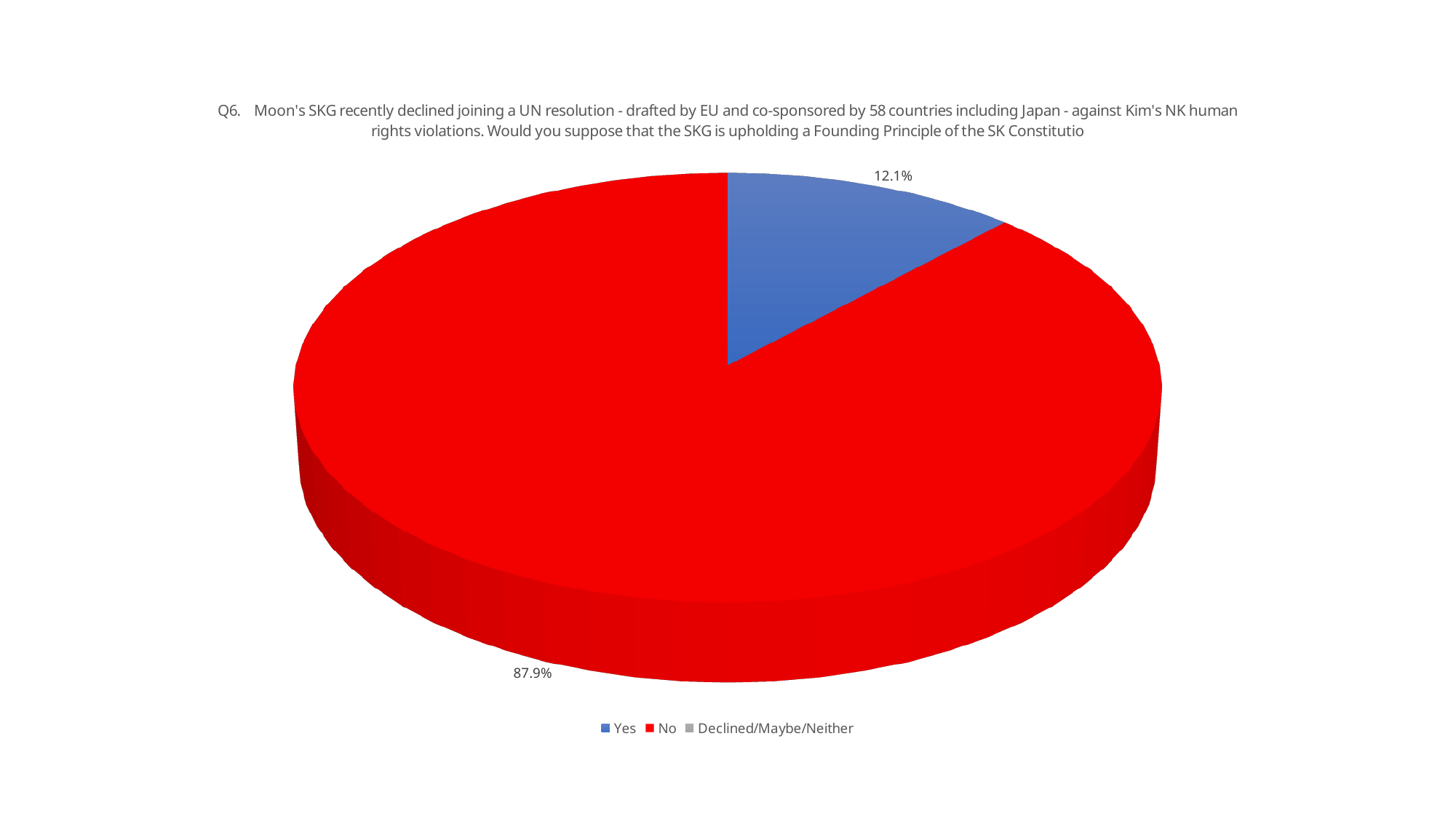
What colour is the "No" slice? Red What percentage of respondents answered "Yes"? 12.1% Which of the two labelled slices is smaller, "Yes" or "No"? Yes What percentage of respondents answered "No"? 87.9% What is the third legend entry after "Yes" and "No"? Declined/Maybe/Neither Which response has the largest share of the pie? No Which is larger, the share for "Yes" or the share for "No"? No What kind of chart is shown on the slide? Pie chart What is the difference in percentage points between the "No" and "Yes" shares? 75.8% How many slices have a visible data label on the pie? 2 Is the share for "No" greater or less than 50%? greater How many entries does the legend list? 3